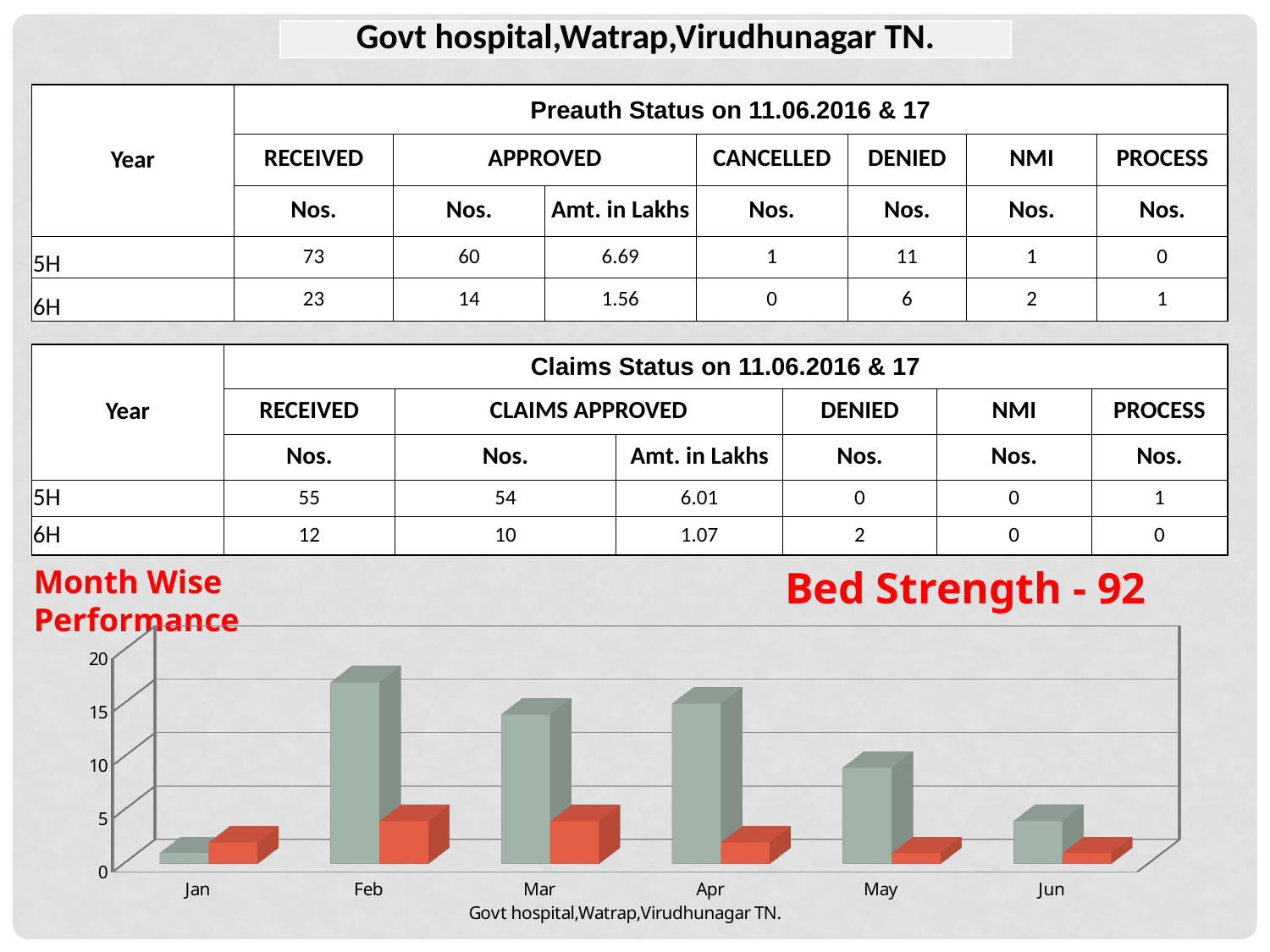
Is the green bar for May greater or less than 10? less What text appears below the x axis of the bar chart? Govt hospital,Watrap,Virudhunagar TN. Which month has the shortest green bar in the bar chart? Jan Which is taller in the bar chart, the green bar for Apr or the green bar for Jun? Apr Which is taller in the bar chart, the green bar for Feb or the green bar for May? Feb Is the green bar for Mar greater or less than 10? greater Do the green bars rise or fall from Feb to Jun in the bar chart? fall Is the green bar for Feb greater or less than 15? greater How many months are shown on the x axis of the bar chart? 6 What kind of chart is shown at the bottom of the slide? bar chart Which month has the tallest green bar in the bar chart? Feb